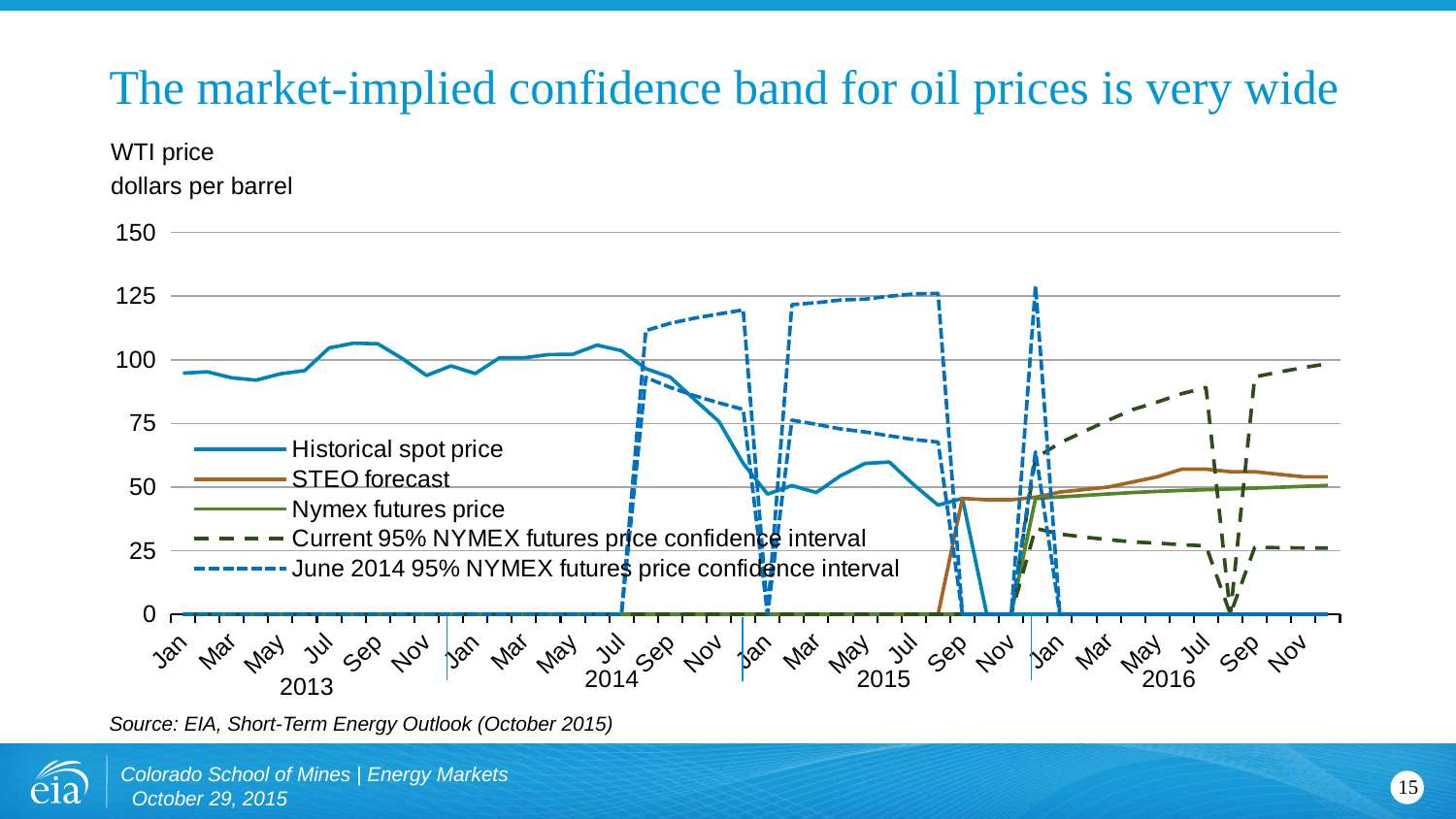
Which is larger, the historical spot price in January 2013 or in January 2015? January 2013 What is the title of the chart on the slide? The market-implied confidence band for oil prices is very wide Is the historical spot price in January 2015 greater or less than 75? less How many series does the legend list? 5 What is the highest value shown on the y axis? 150 Is the lower line of the current 95% NYMEX futures price confidence interval in November 2016 greater or less than 50? less What kind of chart is shown on the slide? line chart How many years are labeled on the x axis? 4 Does the historical spot price rise or fall between July 2014 and January 2015? fall Is the historical spot price in January 2013 greater or less than 75? greater What unit is the WTI price plotted in? dollars per barrel